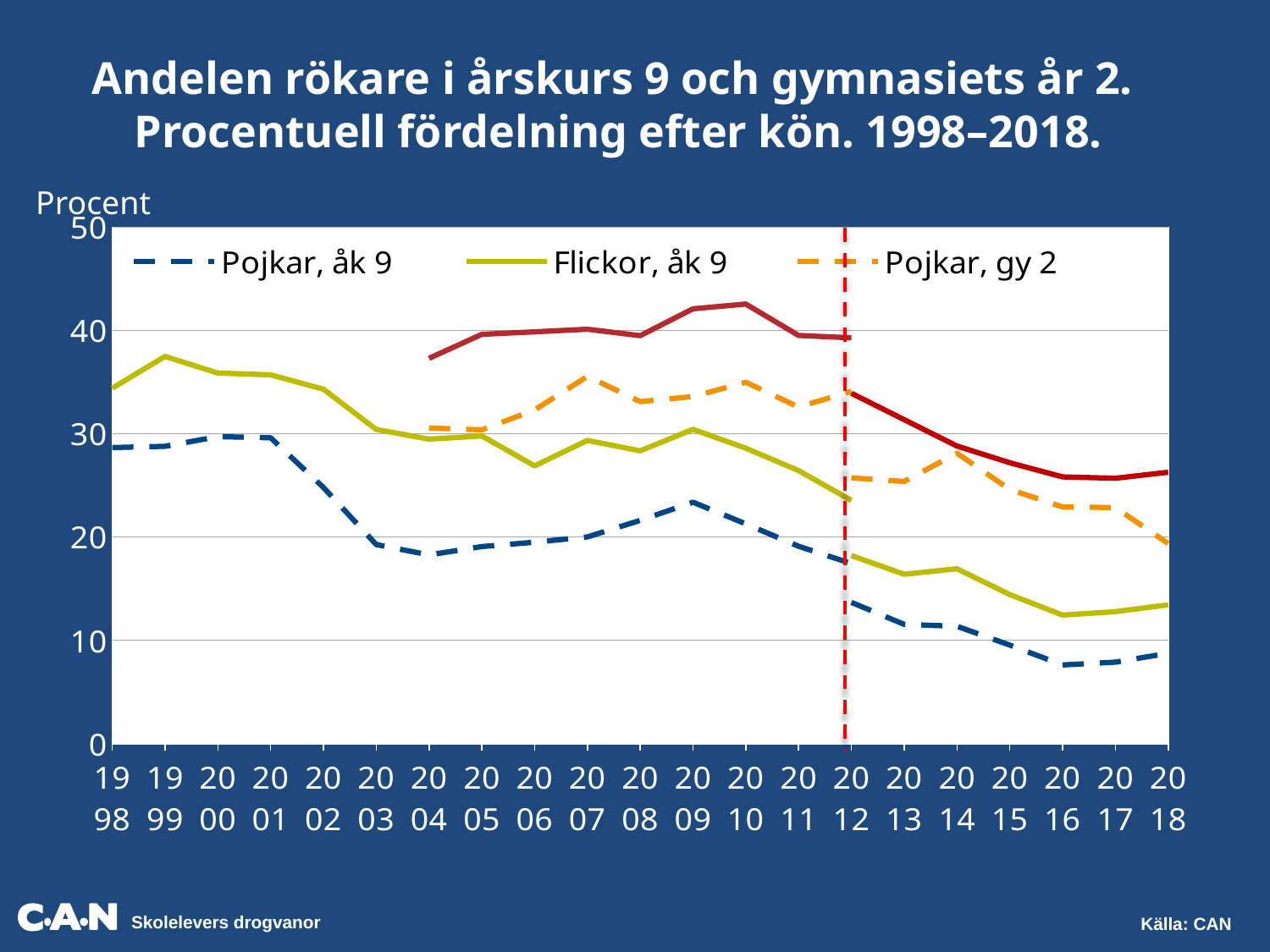
How many series does the legend list? 3 In 2018, which is higher: Flickor, åk 9 or Pojkar, åk 9? Flickor, åk 9 Is the value for Flickor, åk 9 in 1999 greater or less than 30? greater Is the value for Pojkar, gy 2 in 2007 greater or less than 30? greater Does the Flickor, åk 9 line rise or fall from 1999 to 2003? fall What is the label on the y axis? Procent What kind of chart is shown on the slide? line chart In 2010, which is higher: Pojkar, gy 2 or Flickor, åk 9? Pojkar, gy 2 Is the value for Pojkar, åk 9 in 2004 greater or less than 20? less How many years are shown along the x axis? 21 Does the Pojkar, åk 9 line rise or fall from 2012 to 2016? fall